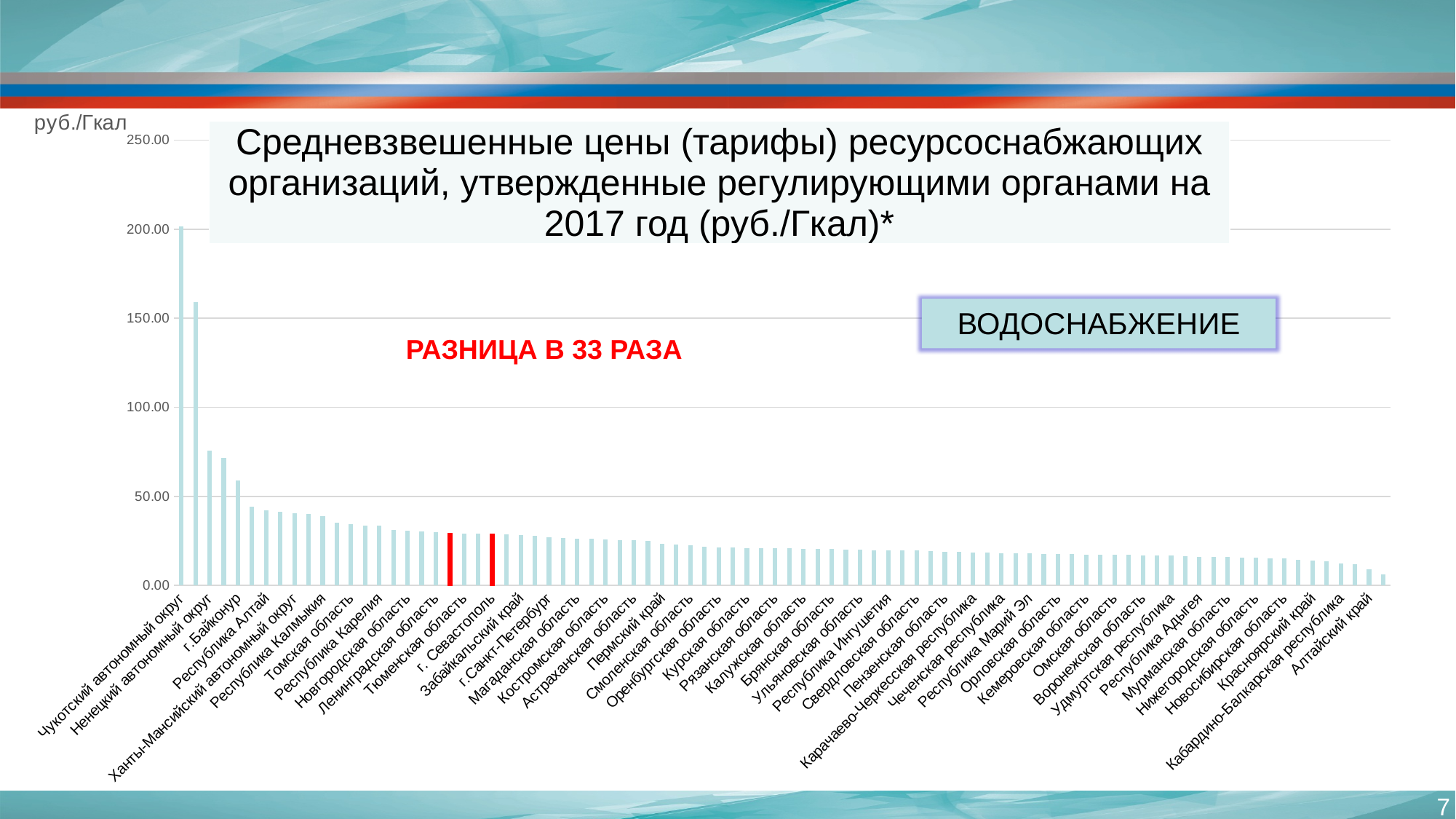
Which region has the highest value in the chart? Чукотский автономный округ Do the values rise or fall from left to right along the x axis? fall Is the value for Республика Алтай greater or less than 50? less What kind of chart is shown on the slide? bar chart What unit is shown on the y axis of the chart? руб./Гкал What text is written in red inside the chart area? РАЗНИЦА В 33 РАЗА Which is larger, the value for Чукотский автономный округ or for Ненецкий автономный округ? Чукотский автономный округ Is the value for Ненецкий автономный округ greater or less than 100? less Is the value for г. Байконур greater or less than 100? less